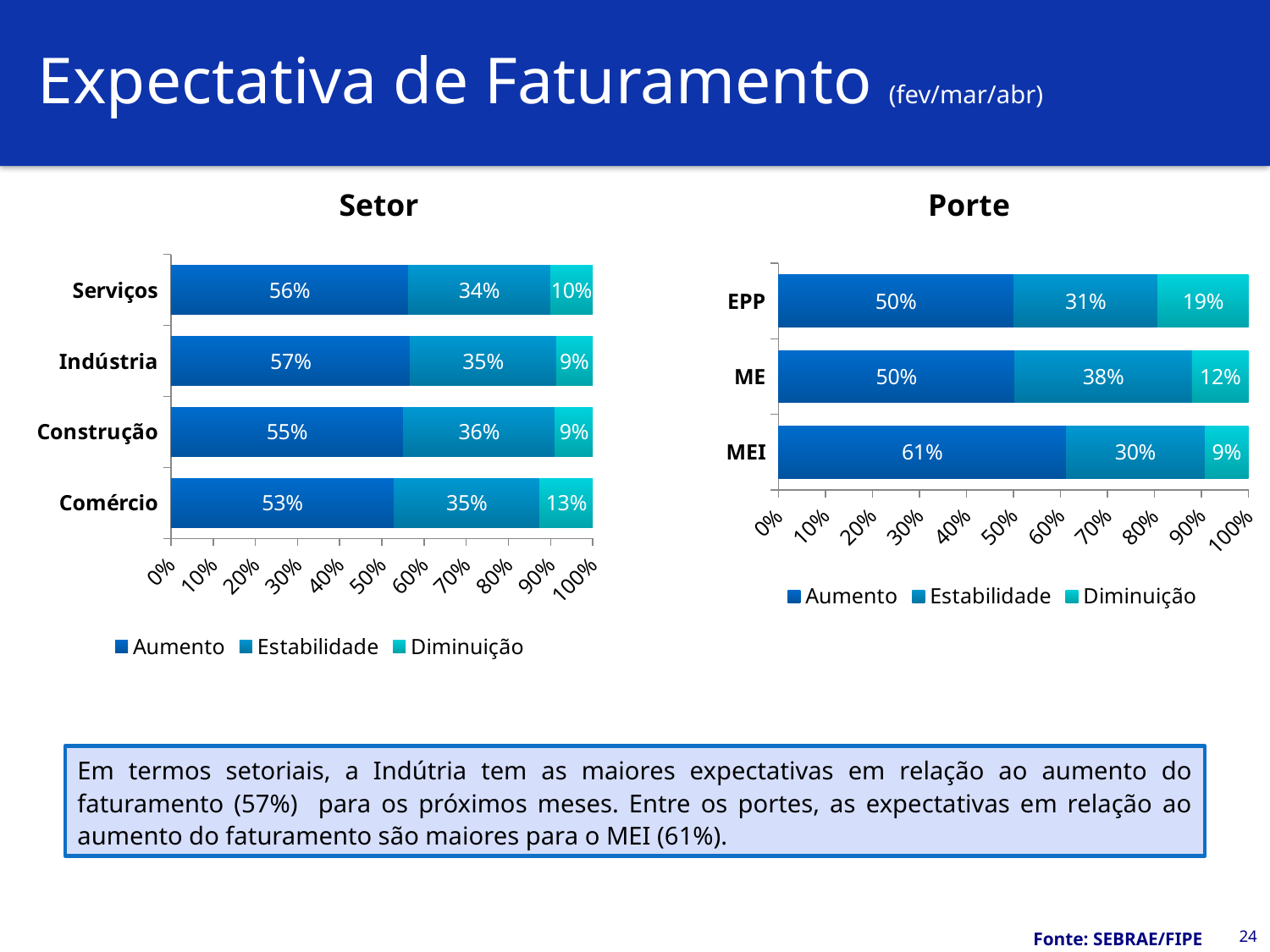
In the 'Porte' chart, which category has the lowest 'Diminuição' value? MEI How many categories are shown in the 'Setor' chart? 4 In the 'Setor' chart, what is the 'Diminuição' value for Comércio? 13% In the 'Porte' chart, which is larger: the 'Aumento' value for MEI or for EPP? MEI In the 'Porte' chart, what is the 'Diminuição' value for EPP? 19% In the 'Setor' chart, what is the difference between the 'Aumento' values for Indústria and Comércio? 4% In the 'Setor' chart, what is the 'Aumento' value for Indústria? 57% What kind of chart is the 'Porte' chart? Stacked bar chart In the 'Porte' chart, what is the 'Estabilidade' value for ME? 38% How many series does the legend of the 'Porte' chart list? 3 In the 'Setor' chart, which category has the highest 'Aumento' value? Indústria What are the three legend entries in the 'Setor' chart? Aumento, Estabilidade, Diminuição